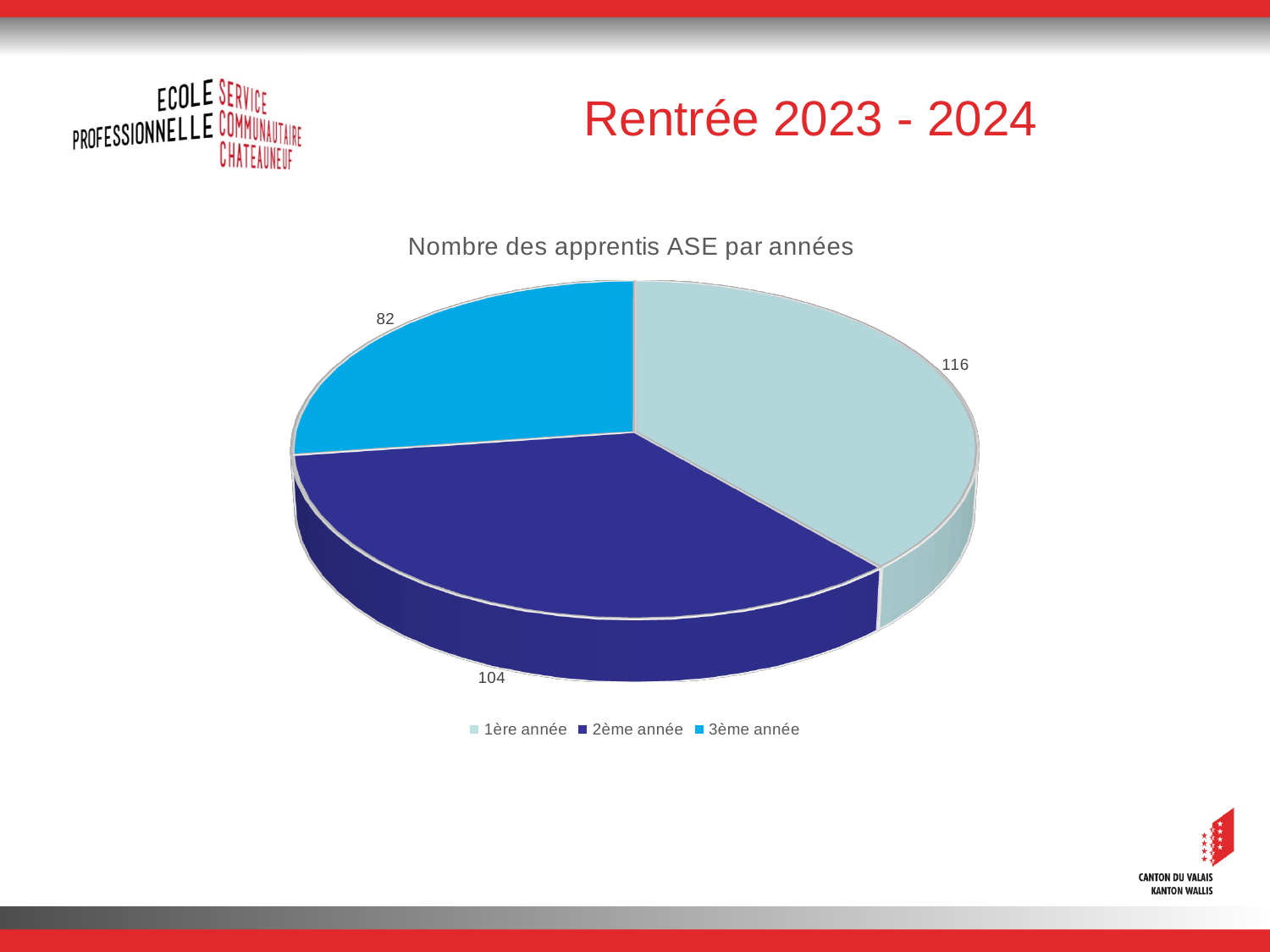
What is the title of the chart? Nombre des apprentis ASE par années What is the difference between the values for 1ère année and 3ème année? 34 How many slices does the pie chart have? 3 Which year has the lowest number of apprentices? 3ème année How many entries does the legend list? 3 What is the value for 3ème année? 82 Which is larger, the value for 2ème année or the value for 3ème année? 2ème année What is the total number of apprentices across all three years? 302 What is the value for 2ème année? 104 What is the value for 1ère année? 116 What type of chart is shown on the slide? Pie chart Which year has the highest number of apprentices? 1ère année